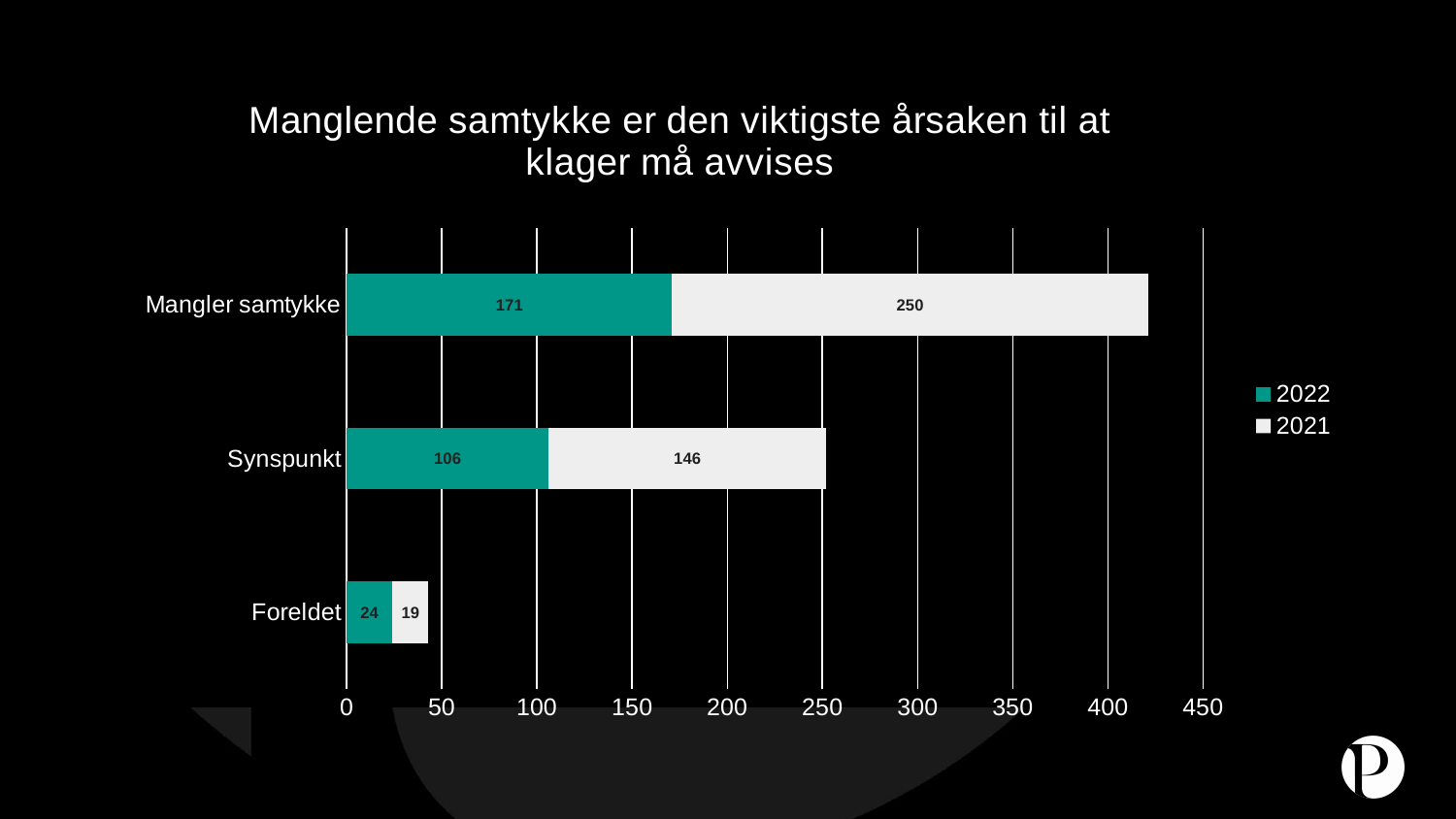
Which category has the highest 2021 value? Mangler samtykke What is the 2022 value for Mangler samtykke? 171 What is the difference between the 2021 and 2022 values for Mangler samtykke? 79 Which category has the lowest 2022 value? Foreldet What is the 2021 value for Synspunkt? 146 What kind of chart is shown on the slide? Stacked bar chart What is the total of the stacked bar for Mangler samtykke? 421 Which is larger for Foreldet, the 2022 value or the 2021 value? 2022 What is the 2021 value for Foreldet? 19 How many series does the legend list? 2 How many categories are shown on the chart? 3 What is the total of the stacked bar for Synspunkt? 252